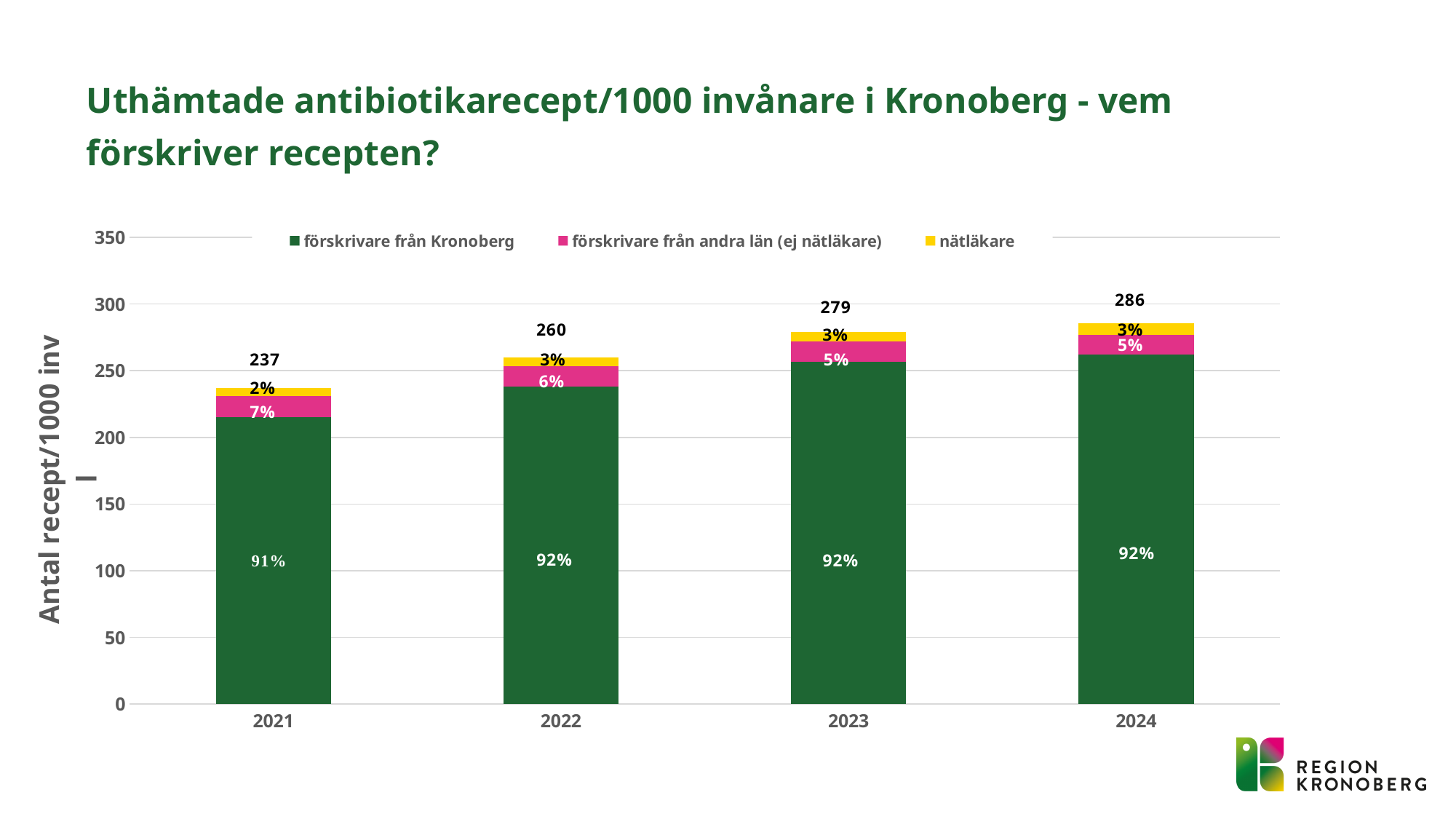
Is the total value for 2021 greater or less than 250? less What percentage share is labelled for 'nätläkare' in 2023? 3% Which year has the highest total value? 2024 What is the total number of prescriptions per 1000 inhabitants shown above the bar for 2021? 237 What is the total value printed above the bar for 2024? 286 How many series does the legend list? 3 What is the difference between the total for 2024 and the total for 2021? 49 What percentage share is labelled for 'förskrivare från andra län (ej nätläkare)' in 2022? 6% Which is larger, the total for 2022 or the total for 2023? 2023 Which year has the lowest total value? 2021 Do the total values rise or fall from 2021 to 2024? rise What percentage share is labelled for 'förskrivare från Kronoberg' in 2021? 91%